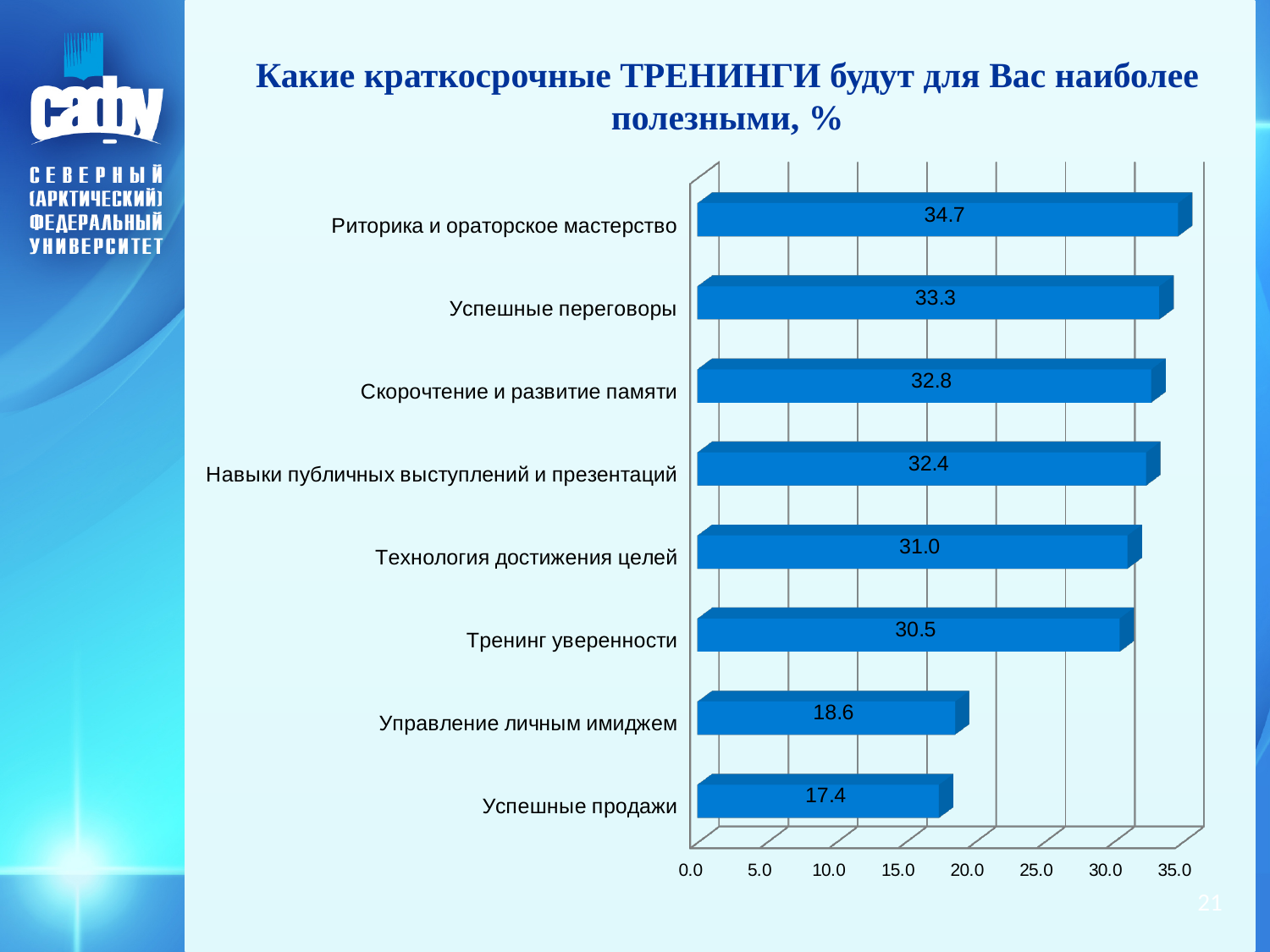
What is the value for Технология достижения целей? 31.0 What is the value for Управление личным имиджем? 18.6 What kind of chart is shown on the slide? bar chart How many categories are shown in the chart? 8 What is the value for Риторика и ораторское мастерство? 34.7 What is the difference between the values for Тренинг уверенности and Управление личным имиджем? 11.9 Which category has the lowest value? Успешные продажи Which category has the highest value? Риторика и ораторское мастерство Is the value for Управление личным имиджем greater or less than 20.0? less Which is larger: the value for Успешные переговоры or the value for Тренинг уверенности? Успешные переговоры What is the difference between the values for Риторика и ораторское мастерство and Успешные продажи? 17.3 What is the title of the chart? Какие краткосрочные ТРЕНИНГИ будут для Вас наиболее полезными, %